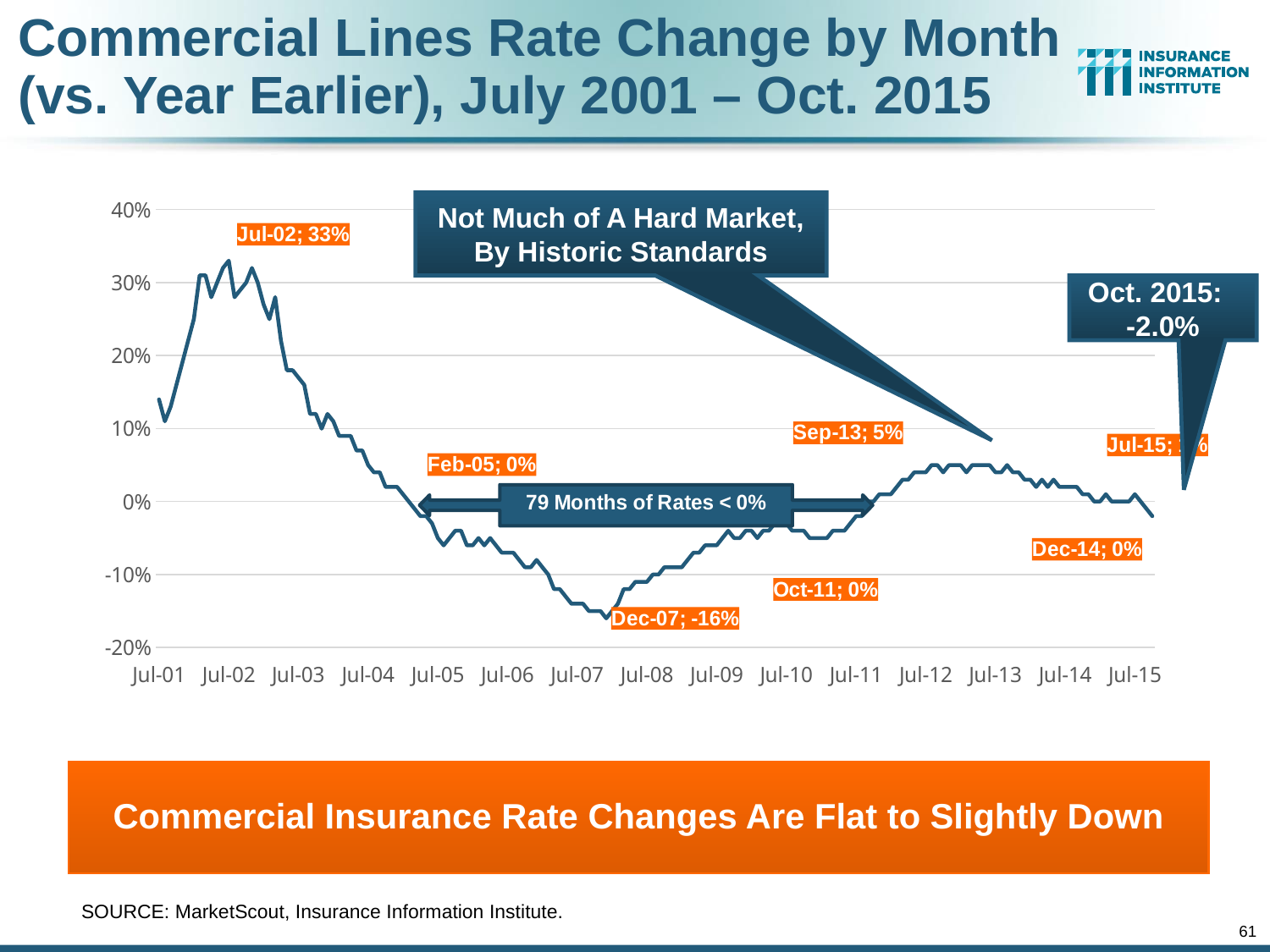
What rate change does the callout give for Oct. 2015? -2.0% What was the commercial lines rate change in Jul-02? 33% Which is larger, the rate change in Sep-13 or in Jul-02? Jul-02 Is the value for Jul-03 greater or less than 10%? greater What was the commercial lines rate change in Sep-13? 5% According to the annotation, for how many months were rates below 0%? 79 Months What kind of chart is shown on the slide? Line chart Which labeled month has the lowest rate change? Dec-07 What was the rate change in Feb-05 according to the data label? 0% What was the commercial lines rate change in Dec-07? -16% What is the difference between the Jul-02 value and the Dec-07 value? 49 percentage points Which labeled month has the highest rate change? Jul-02